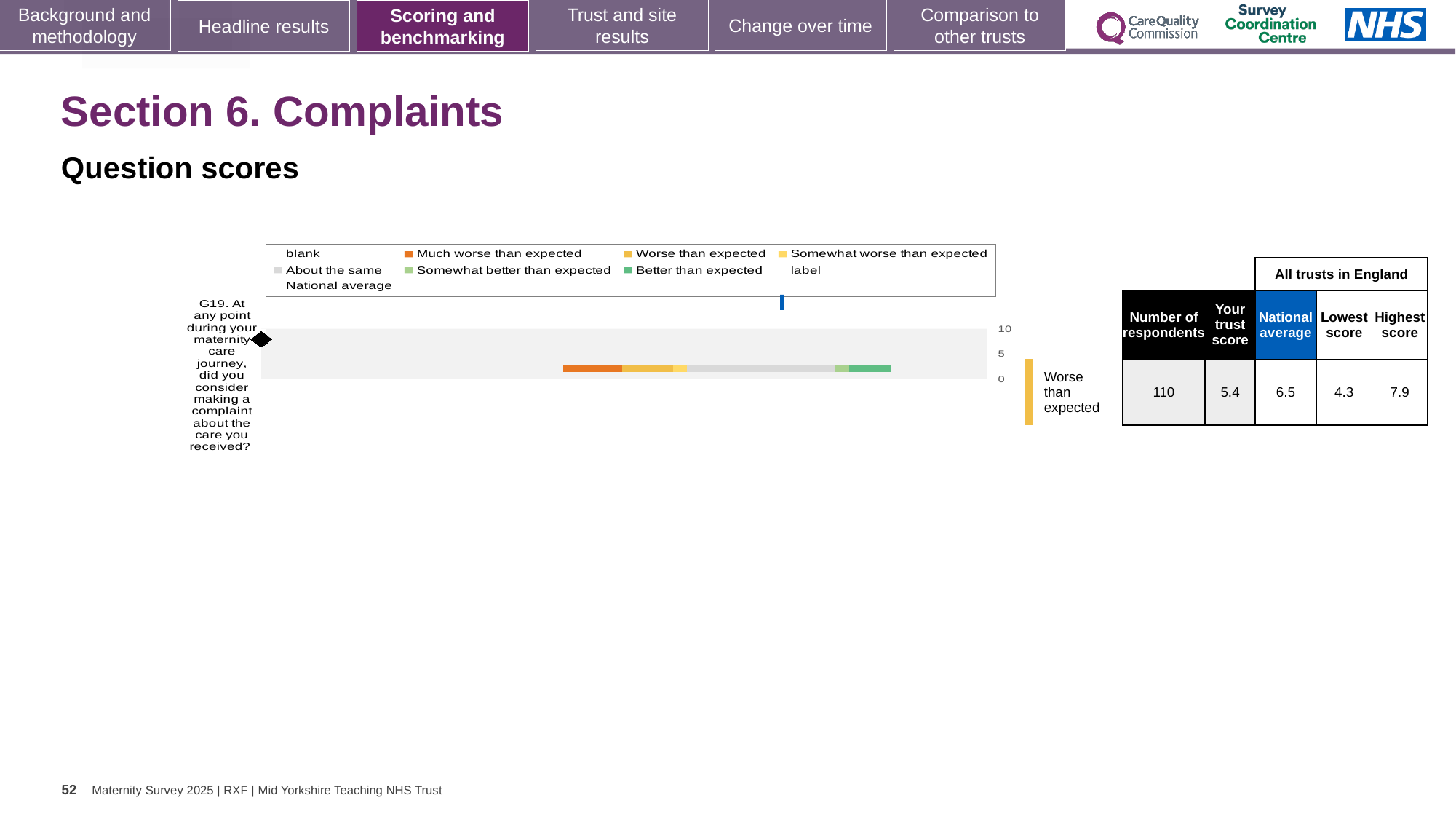
What is the difference between the highest and lowest scores for G19? 3.6 Which is larger for G19, the trust score or the national average? national average What is the highest score across all trusts in England for G19? 7.9 What is the lowest score across all trusts in England for G19? 4.3 How many questions are plotted in the chart? 1 What benchmark category is shown beside the bar for G19? Worse than expected Which question code is plotted in the chart? G19 What is the difference between the national average and the trust score for G19? 1.1 What kind of chart is shown for question G19? bar chart How many respondents answered G19? 110 What is the national average for G19 shown in the table next to the chart? 6.5 What is the trust score for G19 shown in the table next to the chart? 5.4